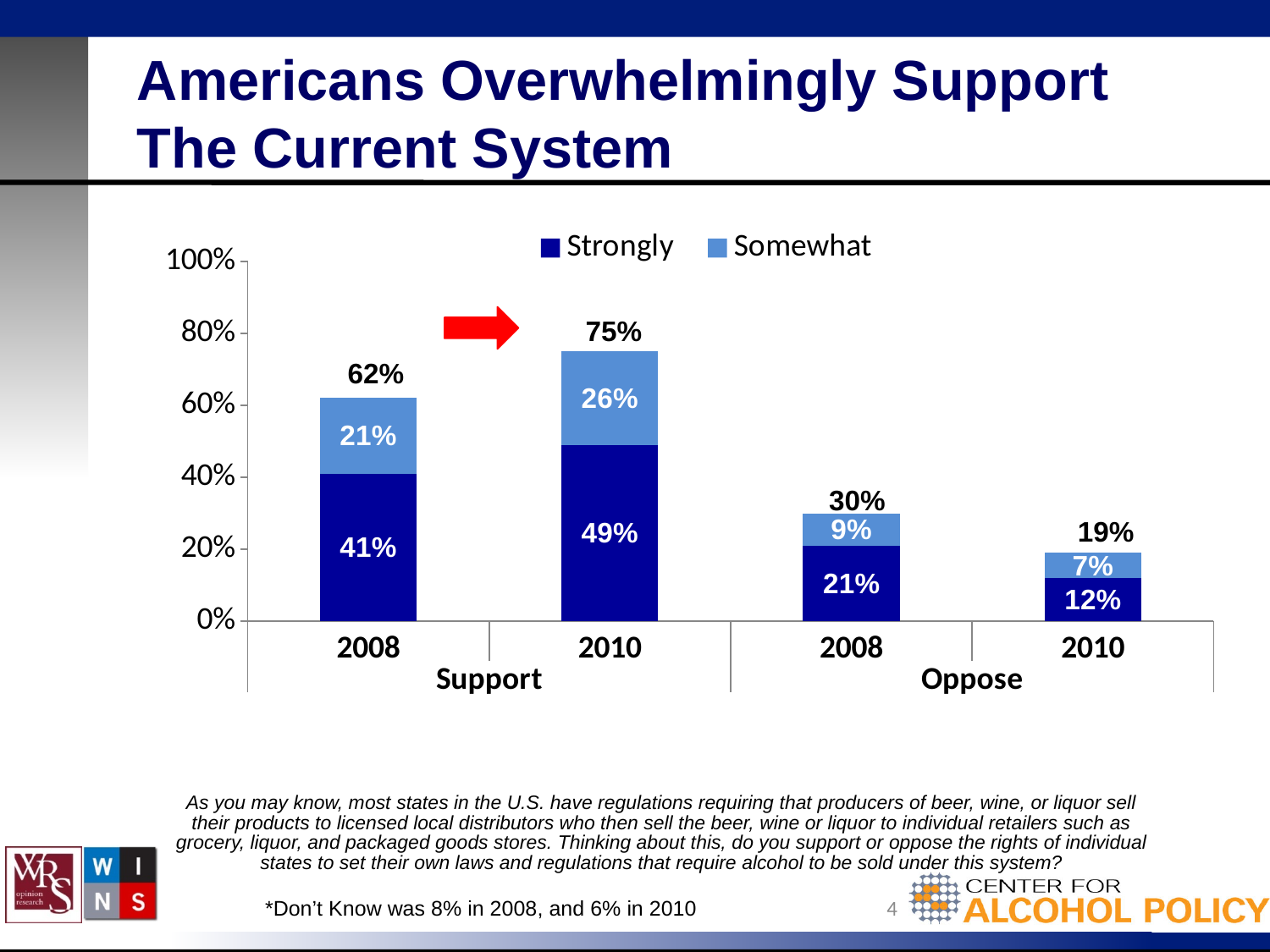
What is the 'Somewhat' value for Oppose in 2008? 9% What is the total for the Oppose 2010 bar? 19% Which bar has the lowest total? Oppose 2010 What is the difference between the Support totals in 2010 and 2008? 13% What is the total for the Support 2008 bar? 62% Which is larger: the 'Somewhat' value for Support in 2010 or for Support in 2008? Support 2010 What is the 'Strongly' value for Oppose in 2010? 12% What is the 'Strongly' value for Support in 2010? 49% Which bar has the highest total? Support 2010 Which legend entry is shown in dark blue? Strongly What kind of chart is shown on the slide? Stacked bar chart How many series does the legend list? 2